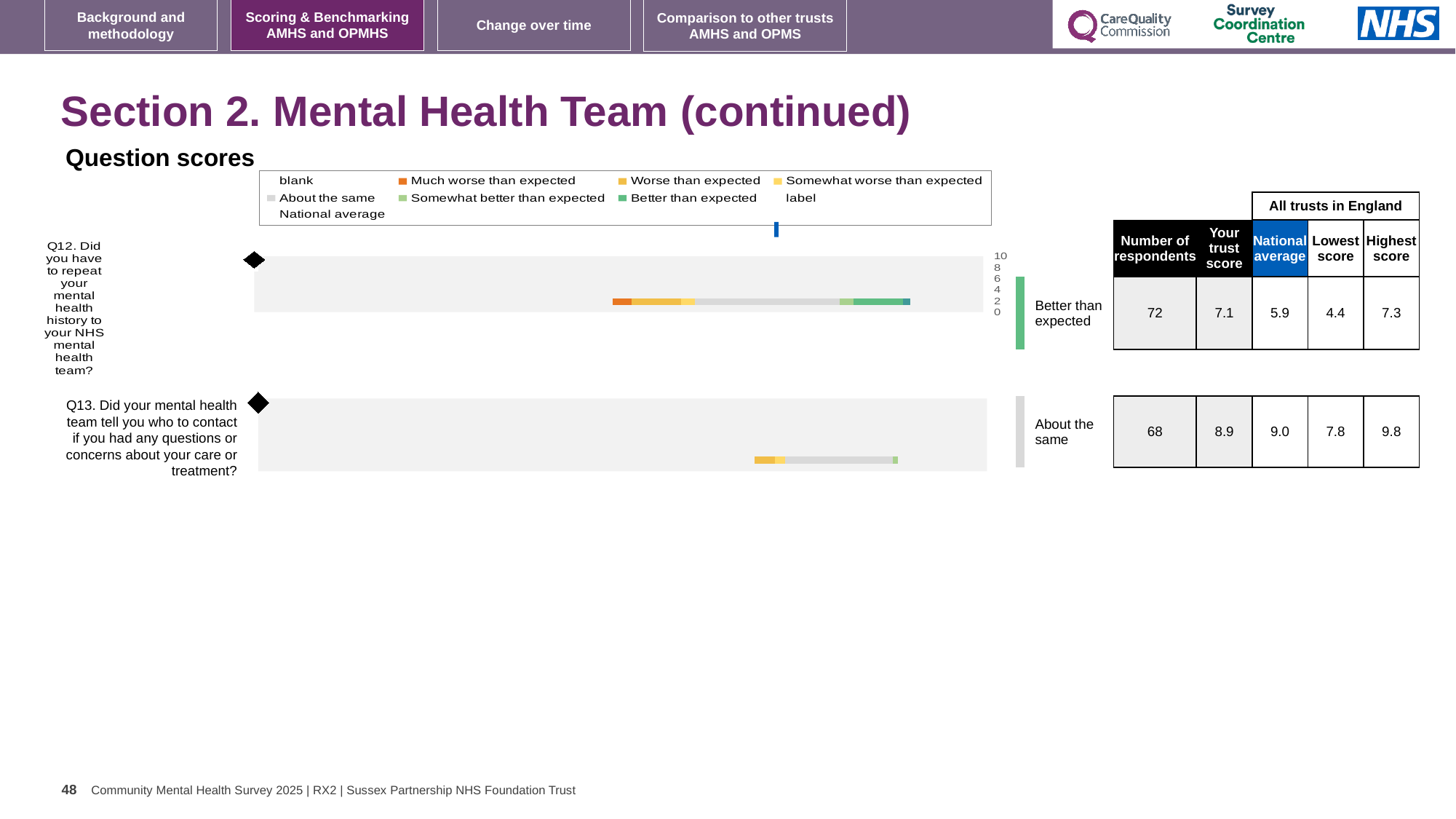
Which question has the lower 'Lowest score' across all trusts in England? Q12 What is the highest score across all trusts in England for Q13? 9.8 What is the trust score for Q12? 7.1 What is the national average for Q13? 9.0 What type of chart is used to show the question scores for Q12 and Q13? bar chart What benchmark category is shown next to the Q13 chart? About the same What benchmark category is shown next to the Q12 chart? Better than expected How many questions are charted on the slide? 2 What is the number of respondents for Q12? 72 What is the highest tick value shown on the chart's axis? 10 For Q13, which is larger: the trust score or the national average? national average What is the difference between the trust score and the national average for Q12? 1.2